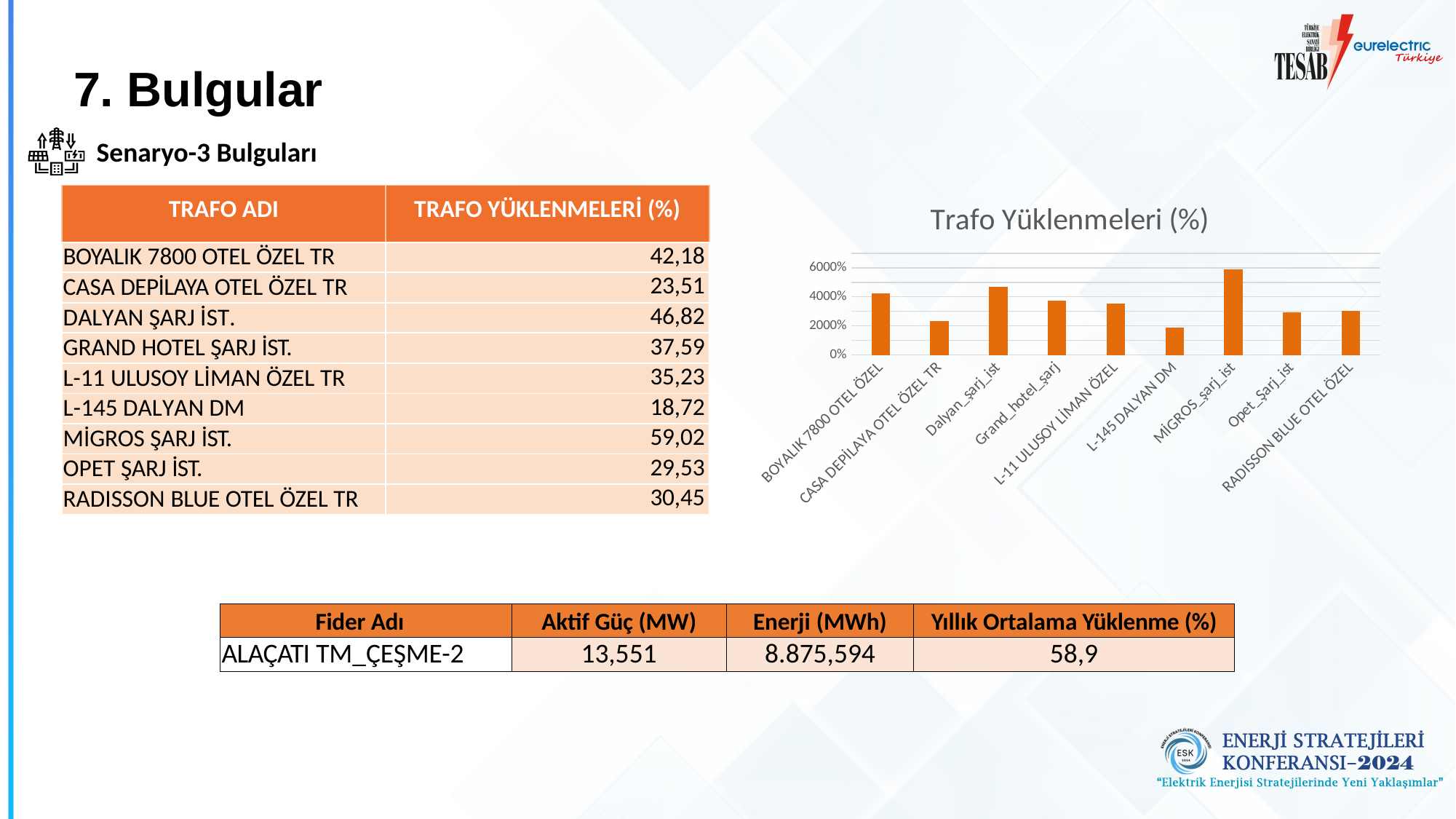
Is the value for Dalyan_şarj_ist greater or less than 4000%? greater What colour are the bars in the chart? orange What kind of chart is shown on the slide? bar chart What is the title of the chart? Trafo Yüklenmeleri (%) How many categories (bars) does the chart show? 9 Is the value for Grand_hotel_şarj greater or less than 4000%? less Which category has the highest bar in the chart? MİGROS_şarj_ist Is the value for RADISSON BLUE OTEL ÖZEL greater or less than 4000%? less Which category has the lowest bar in the chart? L-145 DALYAN DM Which is larger in the chart, the bar for Dalyan_şarj_ist or the bar for Grand_hotel_şarj? Dalyan_şarj_ist Which is larger in the chart, the bar for BOYALIK 7800 OTEL ÖZEL or the bar for CASA DEPİLAYA OTEL ÖZEL TR? BOYALIK 7800 OTEL ÖZEL